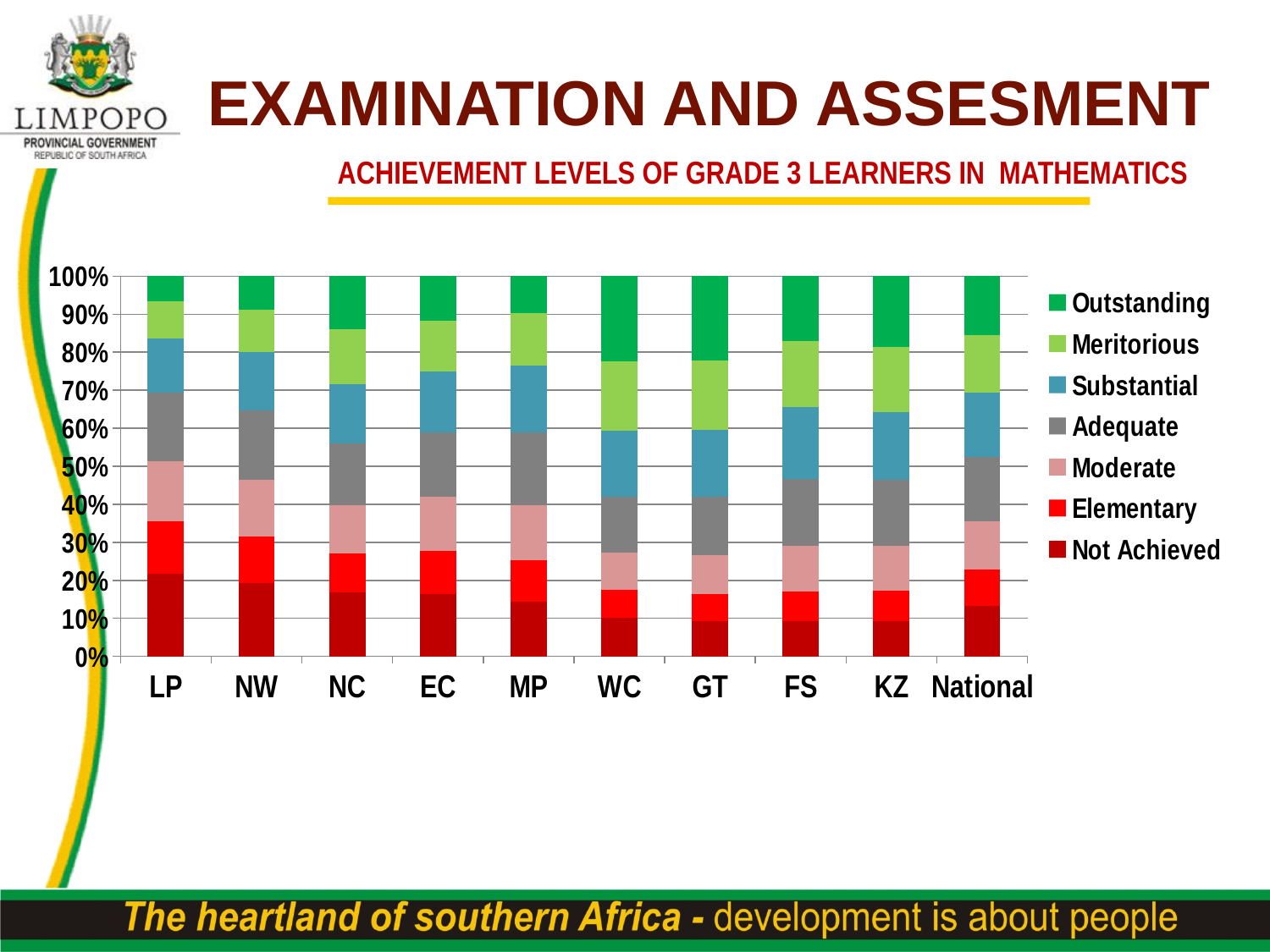
What is the total height of each stacked bar in the chart? 100% Is the Not Achieved share for National greater or less than 20%? less Which province has the largest Not Achieved segment? LP How many series does the chart's legend list? 7 Is the Not Achieved share for LP greater or less than 10%? greater How many categories are shown along the x axis of the chart? 10 Which has the larger Not Achieved segment, LP or WC? LP What is the title of the chart? ACHIEVEMENT LEVELS OF GRADE 3 LEARNERS IN MATHEMATICS What kind of chart is shown on the slide? Stacked bar chart Which has the larger Elementary segment, LP or WC? LP Which achievement level is shown in bright red in the legend? Elementary Is the Not Achieved share for WC greater or less than 20%? less